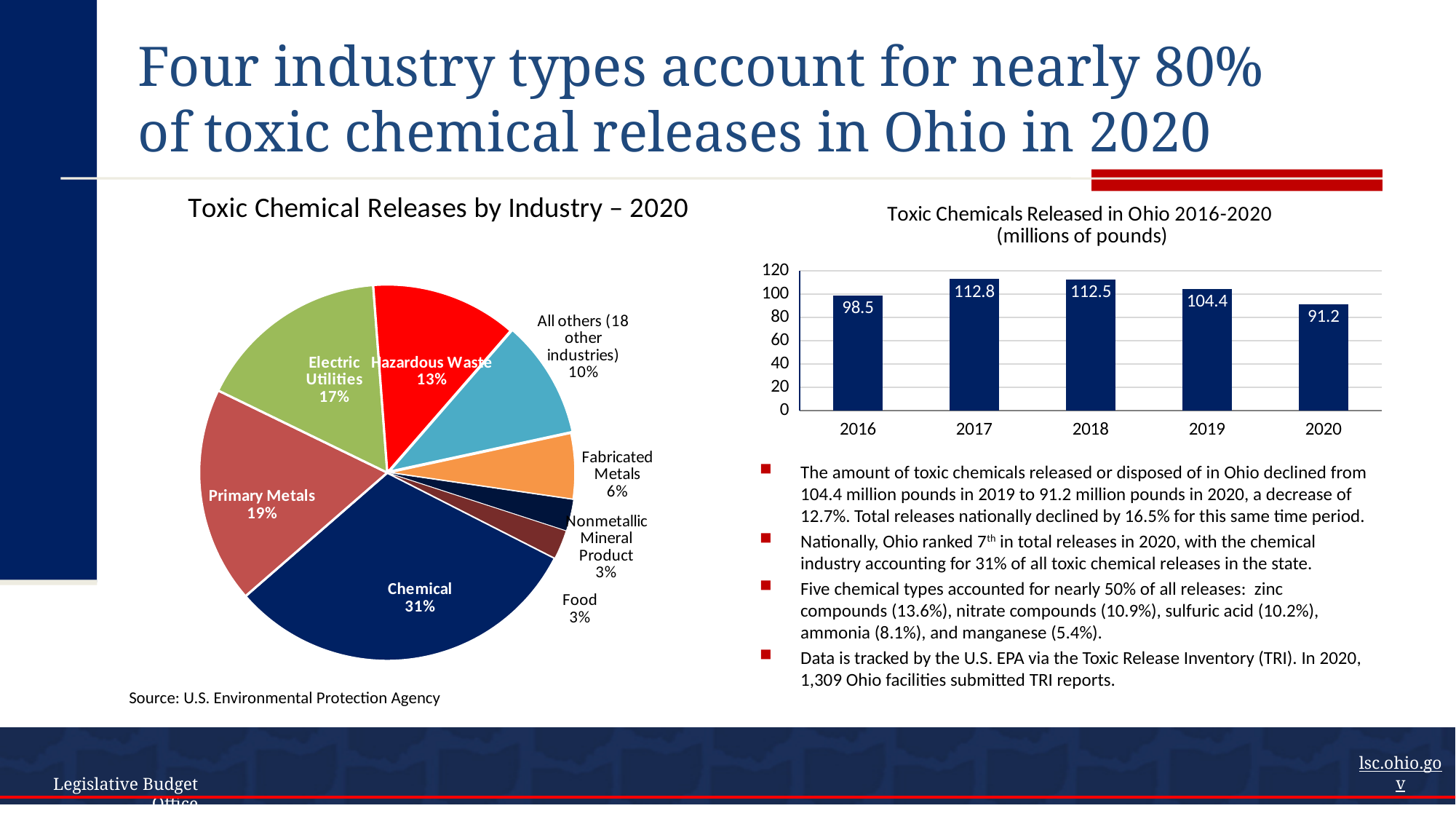
In the 'Toxic Chemical Releases by Industry – 2020' pie chart, what share does Chemical account for? 31% In the 'Toxic Chemicals Released in Ohio 2016-2020' chart, what is the value for 2017? 112.8 In the 'Toxic Chemicals Released in Ohio 2016-2020' chart, how many years are plotted? 5 In the 'Toxic Chemical Releases by Industry – 2020' pie chart, which is larger, Fabricated Metals or Food? Fabricated Metals In the 'Toxic Chemicals Released in Ohio 2016-2020' chart, do the values rise or fall from 2018 to 2020? Fall In the 'Toxic Chemicals Released in Ohio 2016-2020' chart, what is the difference between the 2019 and 2020 values? 13.2 What kind of chart is 'Toxic Chemicals Released in Ohio 2016-2020'? Bar chart In the 'Toxic Chemical Releases by Industry – 2020' pie chart, which industry has the largest slice? Chemical In the 'Toxic Chemical Releases by Industry – 2020' pie chart, what share does Primary Metals account for? 19% In the 'Toxic Chemicals Released in Ohio 2016-2020' chart, which year has the lowest value? 2020 In the 'Toxic Chemical Releases by Industry – 2020' pie chart, what is the difference in percentage points between Electric Utilities and Hazardous Waste? 4 percentage points In the 'Toxic Chemical Releases by Industry – 2020' pie chart, how many slices are shown? 8